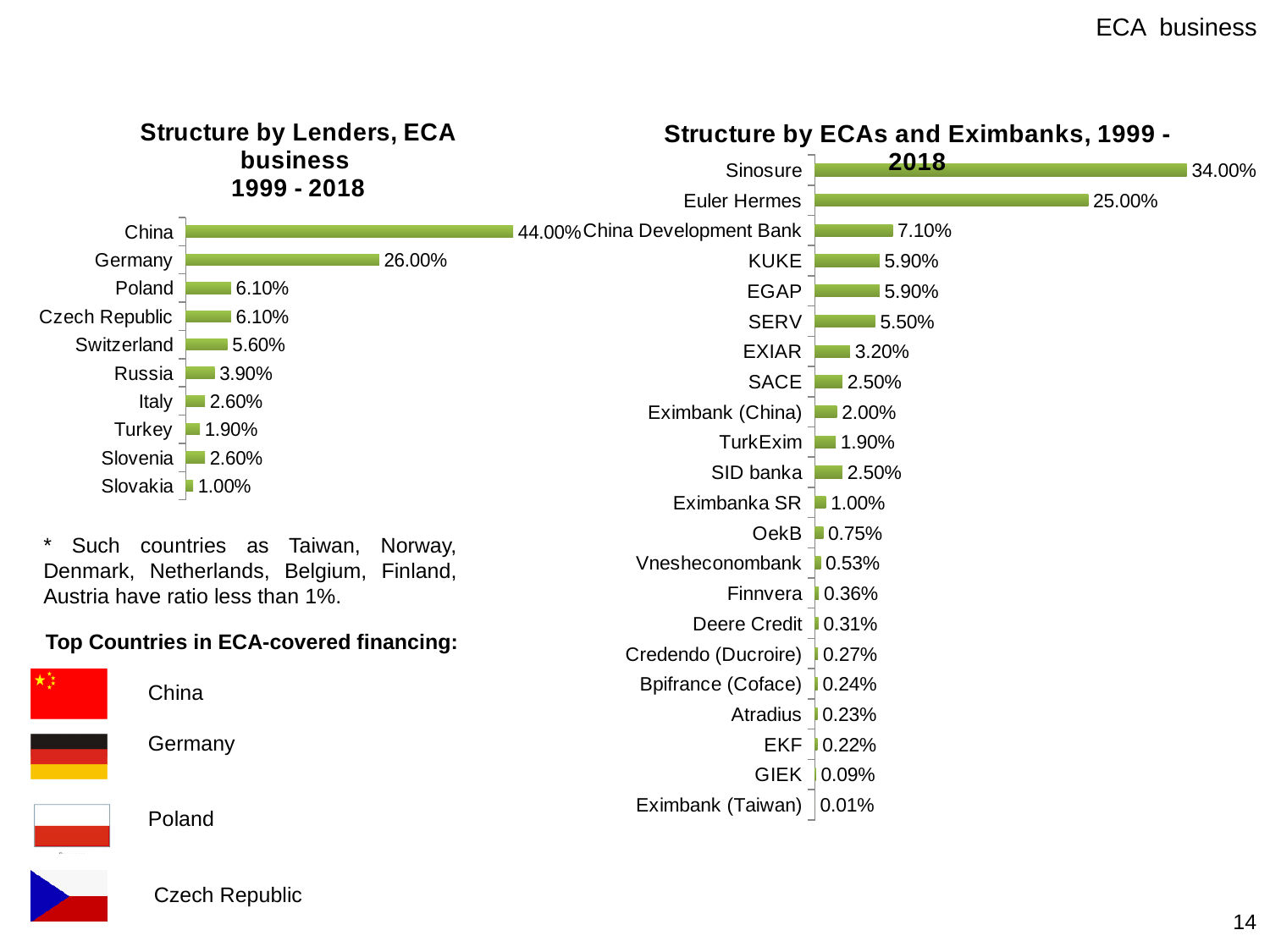
What kind of chart is the 'Structure by ECAs and Eximbanks, 1999 - 2018' chart? Bar chart In the 'Structure by Lenders, ECA business 1999 - 2018' chart, which country has the lowest value? Slovakia In the 'Structure by ECAs and Eximbanks, 1999 - 2018' chart, what is the value for EXIAR? 3.20% In the 'Structure by Lenders, ECA business 1999 - 2018' chart, what is the difference between the values for China and Germany? 18.00% In the 'Structure by Lenders, ECA business 1999 - 2018' chart, which country has the highest value? China In the 'Structure by ECAs and Eximbanks, 1999 - 2018' chart, which is larger: the value for Euler Hermes or the value for China Development Bank? Euler Hermes In the 'Structure by Lenders, ECA business 1999 - 2018' chart, what is the value for Germany? 26.00% In the 'Structure by ECAs and Eximbanks, 1999 - 2018' chart, what is the value for Sinosure? 34.00% In the 'Structure by ECAs and Eximbanks, 1999 - 2018' chart, which entity has the lowest value? Eximbank (Taiwan) In the 'Structure by ECAs and Eximbanks, 1999 - 2018' chart, how many entities are shown? 22 In the 'Structure by Lenders, ECA business 1999 - 2018' chart, what is the value for Russia? 3.90% In the 'Structure by Lenders, ECA business 1999 - 2018' chart, how many countries are shown? 10